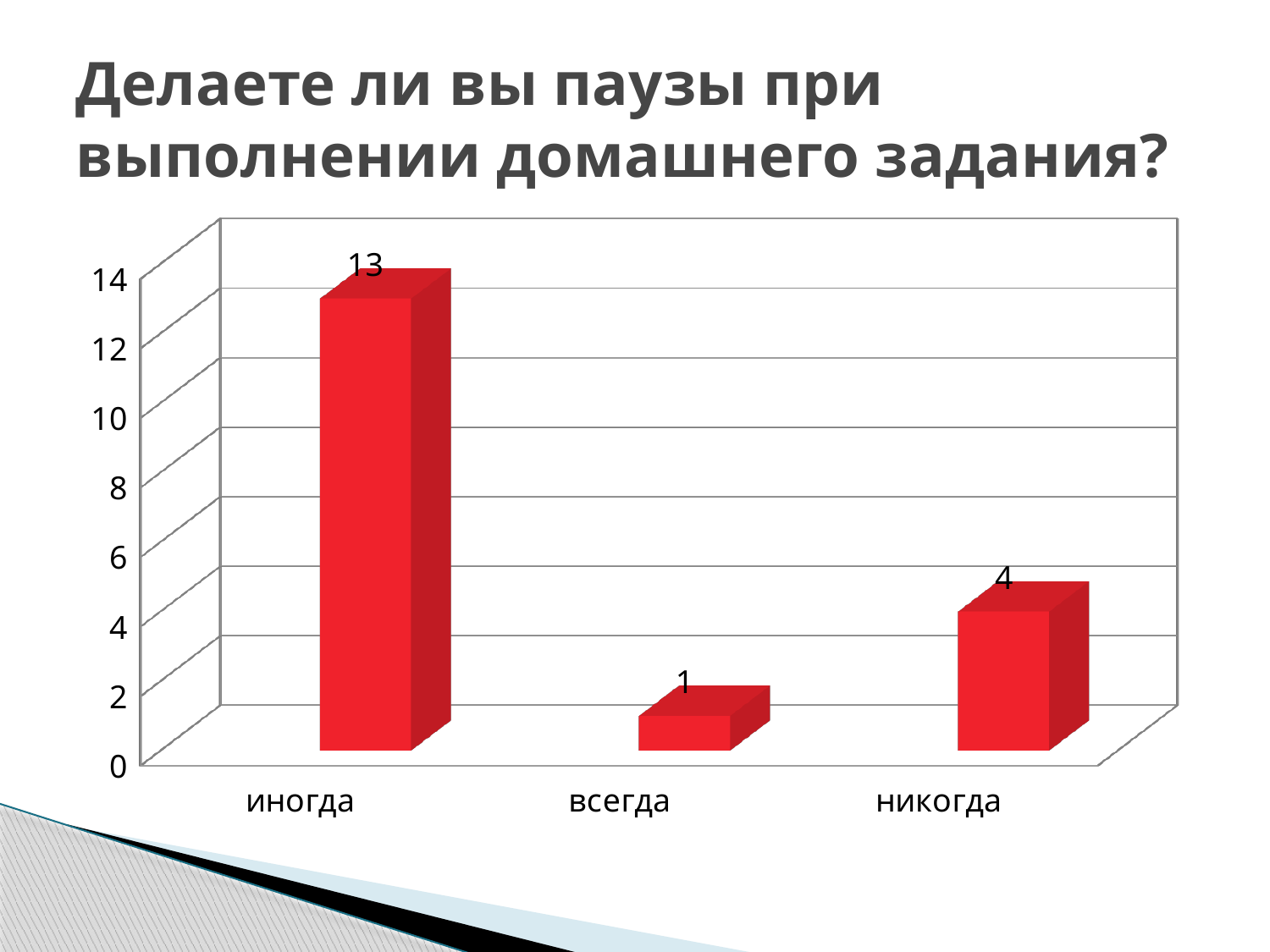
What kind of chart is shown on the slide? bar chart Which category has the lowest value? всегда What is the value for "никогда"? 4 What is the difference between the values for "никогда" and "всегда"? 3 How many categories are shown on the x axis? 3 Is the value for "иногда" greater or less than 10? greater What is the difference between the values for "иногда" and "никогда"? 9 Which category has the highest value? иногда What is the value for "всегда"? 1 What is the value for "иногда"? 13 Which is larger, the value for "никогда" or the value for "всегда"? никогда What is the title of the slide? Делаете ли вы паузы при выполнении домашнего задания?